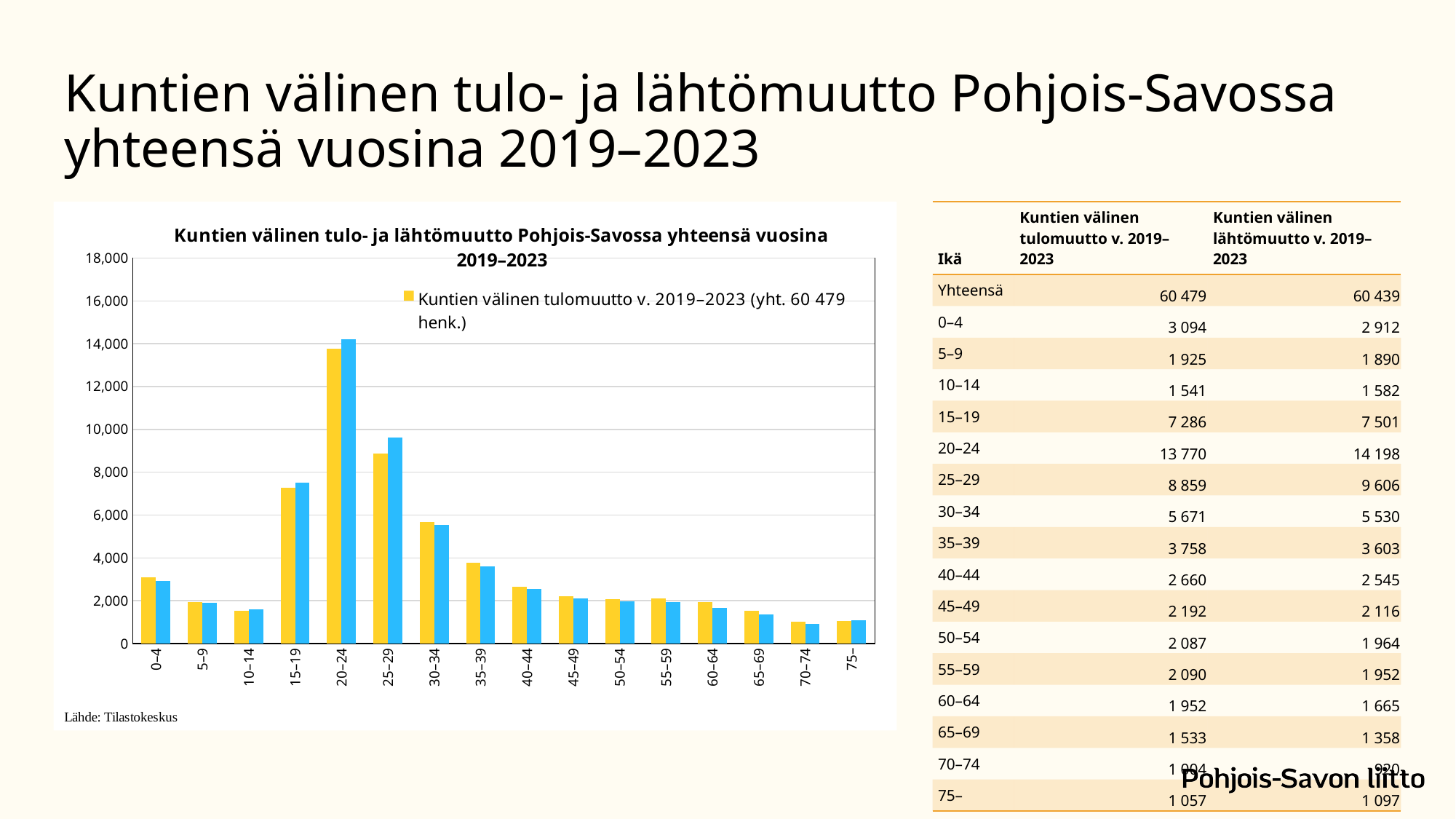
What kind of chart is shown on the slide? bar chart How many age groups are shown on the x axis of the chart? 16 Which age group has a taller yellow (tulomuutto) bar, 0–4 or 5–9? 0–4 Is the yellow (tulomuutto) bar for the 10–14 age group greater or less than 2,000? less Is the yellow (tulomuutto) bar for the 15–19 age group greater or less than 6,000? greater Do the bar values rise or fall along the x axis from the 20–24 age group to the 75– age group? fall According to the table on the slide, what is the tulomuutto value for the 20–24 age group? 13 770 Which age group has the highest bars in the chart? 20–24 Is the yellow (tulomuutto) bar for the 20–24 age group greater or less than 12,000? greater Which age group has a taller yellow (tulomuutto) bar, 15–19 or 30–34? 15–19 What total number of people (henk.) does the legend give for the tulomuutto series? 60 479